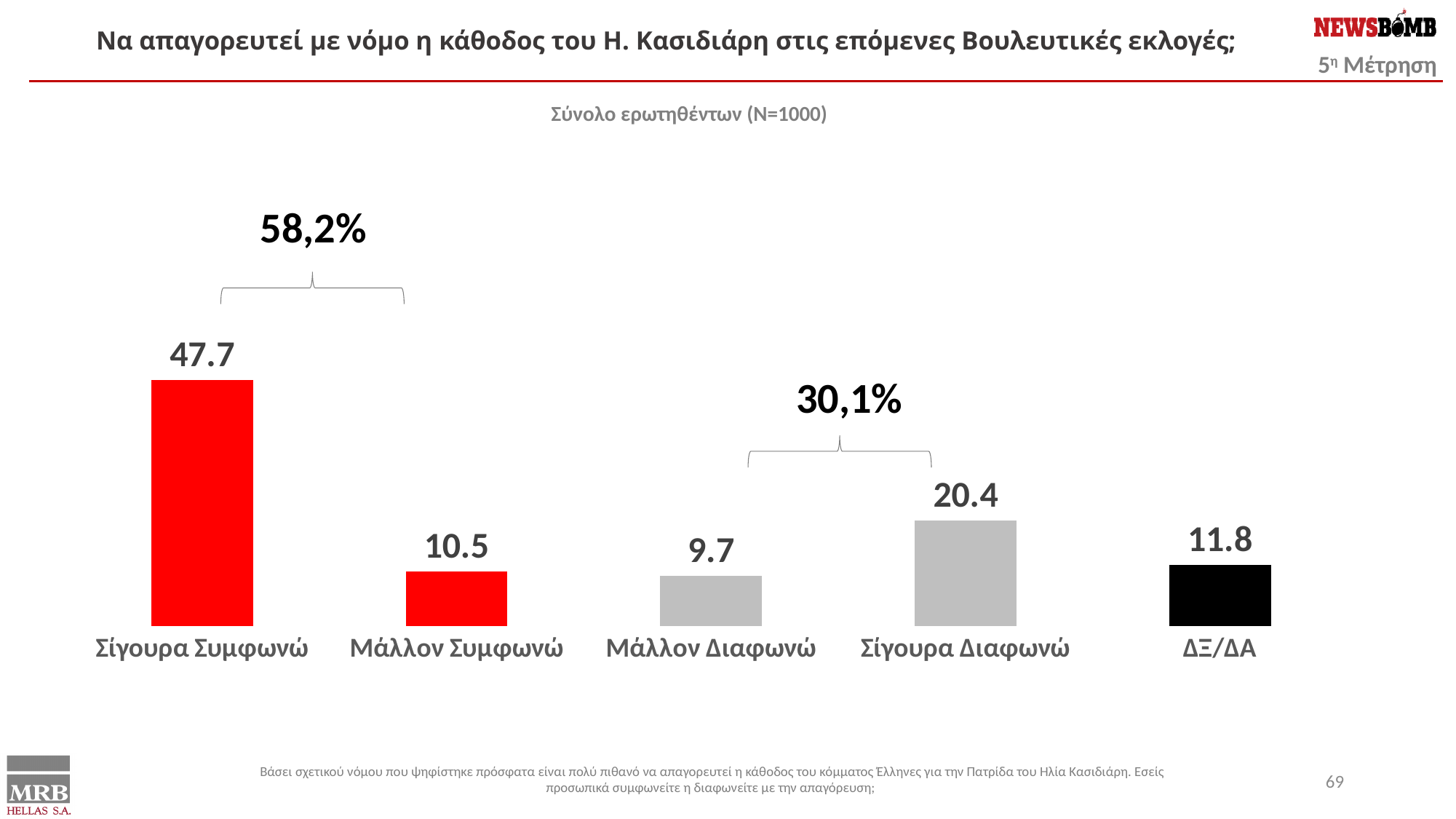
What is the value for Σίγουρα Συμφωνώ? 47.7 What is the difference between the values for Σίγουρα Συμφωνώ and Σίγουρα Διαφωνώ? 27.3 How many categories are shown in the chart? 5 What is the value for Μάλλον Συμφωνώ? 10.5 What is the value for ΔΞ/ΔΑ? 11.8 Which category has the lowest value? Μάλλον Διαφωνώ What is the value for Σίγουρα Διαφωνώ? 20.4 What is the value for Μάλλον Διαφωνώ? 9.7 What kind of chart is shown on the slide? Bar chart Which category has the highest value? Σίγουρα Συμφωνώ What combined percentage is shown above the bracket grouping Σίγουρα Συμφωνώ and Μάλλον Συμφωνώ? 58,2% Which is larger, the value for Σίγουρα Διαφωνώ or the value for ΔΞ/ΔΑ? Σίγουρα Διαφωνώ